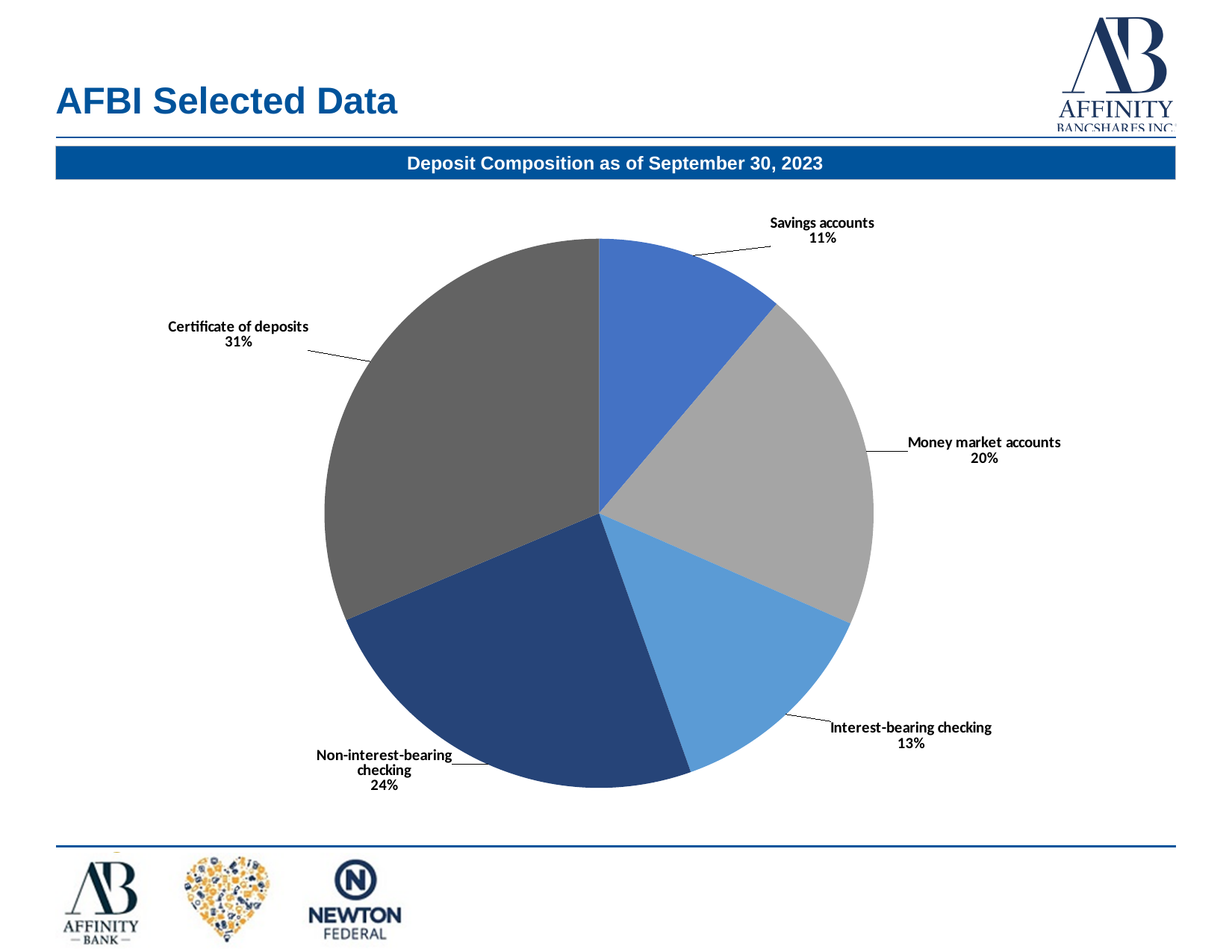
What share of deposits is Money market accounts? 20% What share of deposits is Savings accounts? 11% What is the title of the chart? Deposit Composition as of September 30, 2023 What share of deposits is Interest-bearing checking? 13% What kind of chart is shown on the slide? pie chart Which deposit category has the largest share? Certificate of deposits Which is larger, Money market accounts or Interest-bearing checking? Money market accounts How many deposit categories are shown in the pie chart? 5 Which deposit category has the smallest share? Savings accounts How many percentage points larger is Certificate of deposits than Non-interest-bearing checking? 7